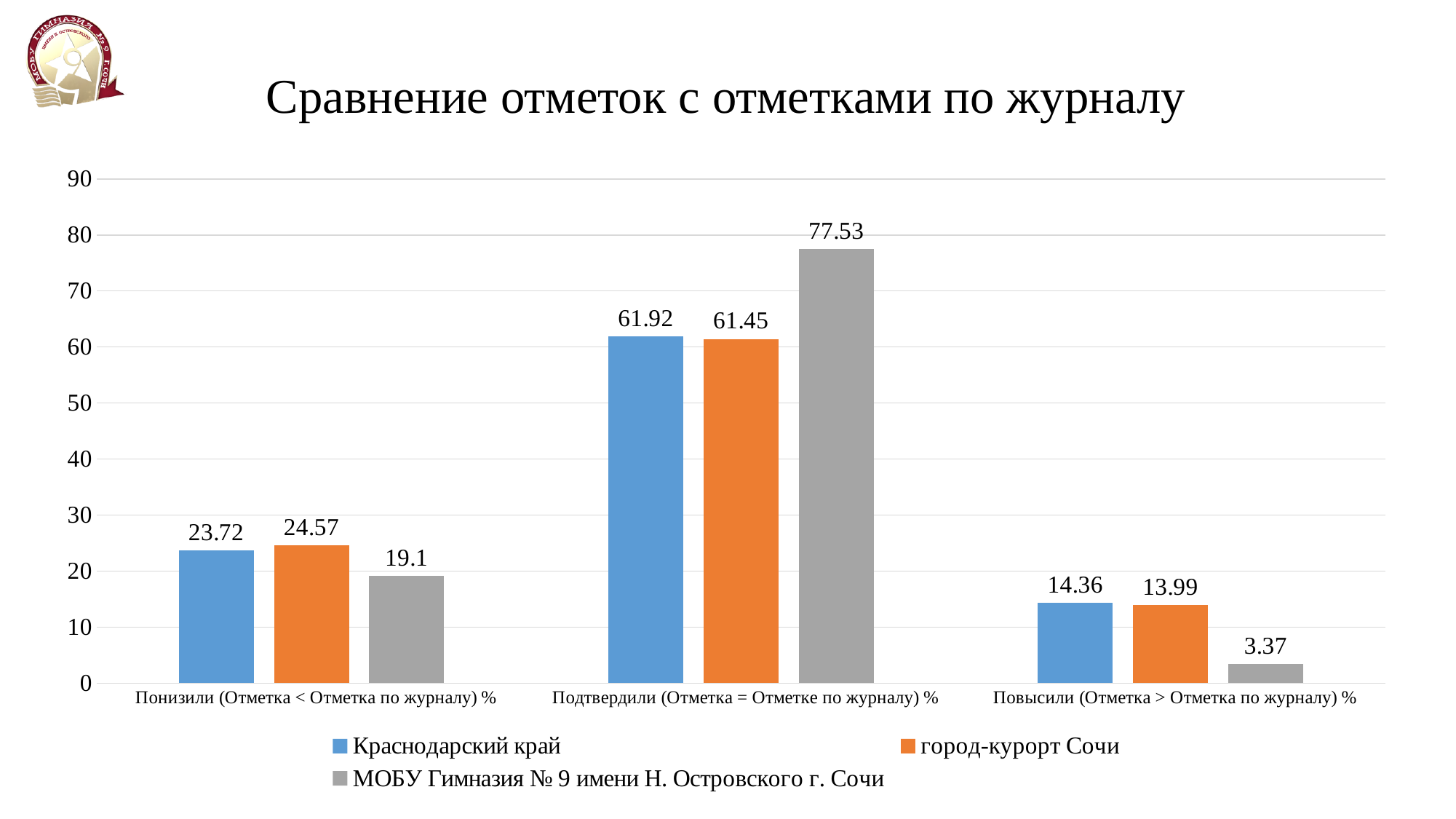
What kind of chart is shown on the slide? bar chart How many categories are shown on the x axis? 3 What is the difference between the МОБУ Гимназия № 9 value and the Краснодарский край value in the Подтвердили (Отметка = Отметке по журналу) % category? 15.61 Which series has the highest value in the Подтвердили (Отметка = Отметке по журналу) % category? МОБУ Гимназия № 9 имени Н. Островского г. Сочи What is the value for город-курорт Сочи in the Повысили (Отметка > Отметка по журналу) % category? 13.99 How many series does the legend list? 3 Is the value for город-курорт Сочи in the Подтвердили (Отметка = Отметке по журналу) % category greater or less than 60? greater Which series has the lowest value in the Повысили (Отметка > Отметка по журналу) % category? МОБУ Гимназия № 9 имени Н. Островского г. Сочи What is the value for МОБУ Гимназия № 9 имени Н. Островского г. Сочи in the Подтвердили (Отметка = Отметке по журналу) % category? 77.53 What is the value for Краснодарский край in the Понизили (Отметка < Отметка по журналу) % category? 23.72 Which is larger in the Понизили (Отметка < Отметка по журналу) % category: Краснодарский край or МОБУ Гимназия № 9? Краснодарский край What is the title of the chart? Сравнение отметок с отметками по журналу